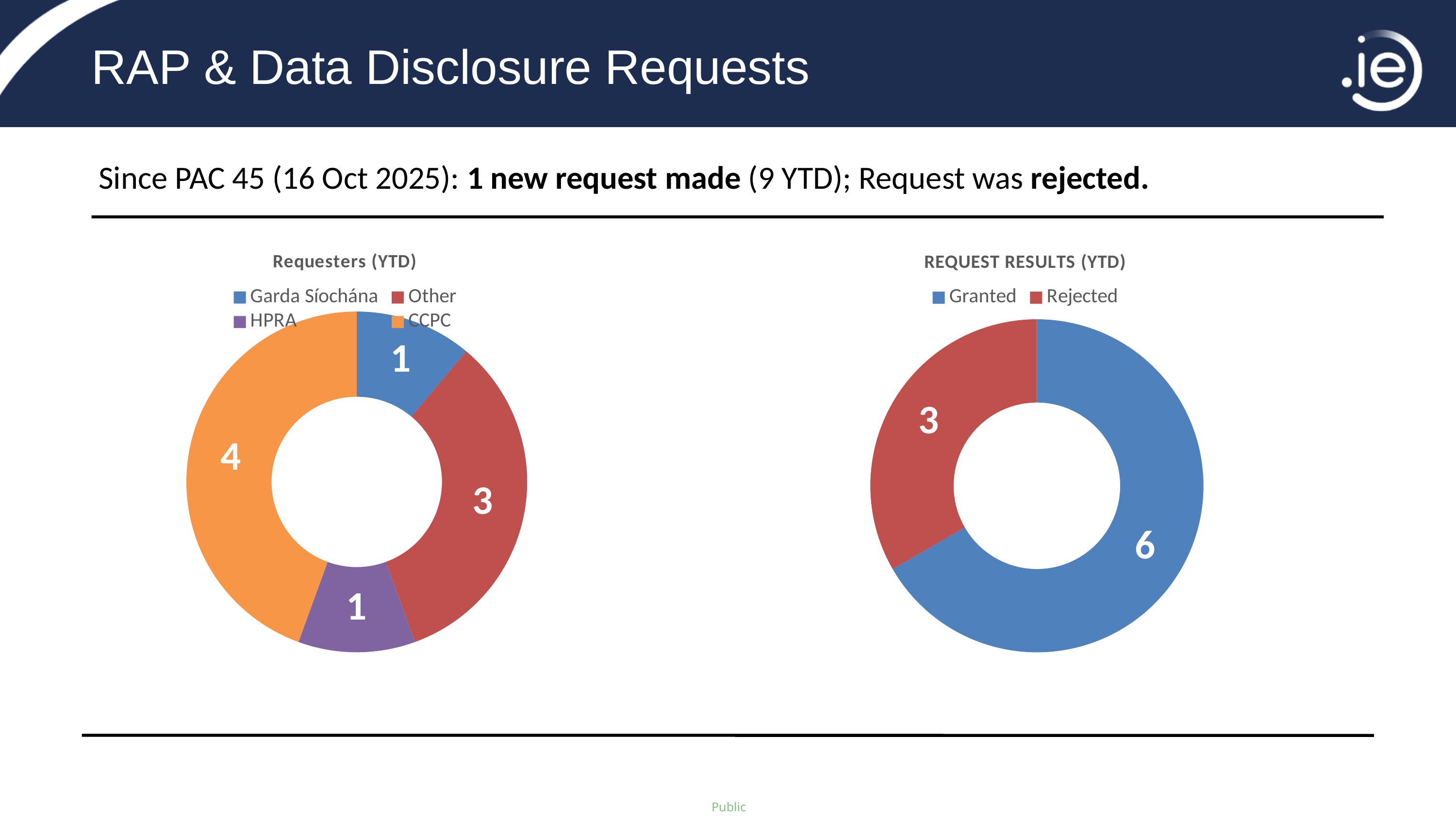
In the 'Requesters (YTD)' chart, what is the value for Other? 3 In the 'REQUEST RESULTS (YTD)' chart, what is the difference between Granted and Rejected? 3 In the 'Requesters (YTD)' chart, which requester has the highest value? CCPC In the 'REQUEST RESULTS (YTD)' chart, which is larger, Granted or Rejected? Granted In the 'Requesters (YTD)' chart, what is the difference between the values for CCPC and Other? 1 In the 'Requesters (YTD)' chart, what colour is the HPRA slice? Purple In the 'Requesters (YTD)' chart, how many categories does the legend list? 4 In the 'REQUEST RESULTS (YTD)' chart, what is the value for Granted? 6 In the 'Requesters (YTD)' chart, what is the total of all the slices? 9 What kind of chart is the 'REQUEST RESULTS (YTD)' chart? Doughnut chart In the 'REQUEST RESULTS (YTD)' chart, what is the value for Rejected? 3 In the 'Requesters (YTD)' chart, what is the value for CCPC? 4